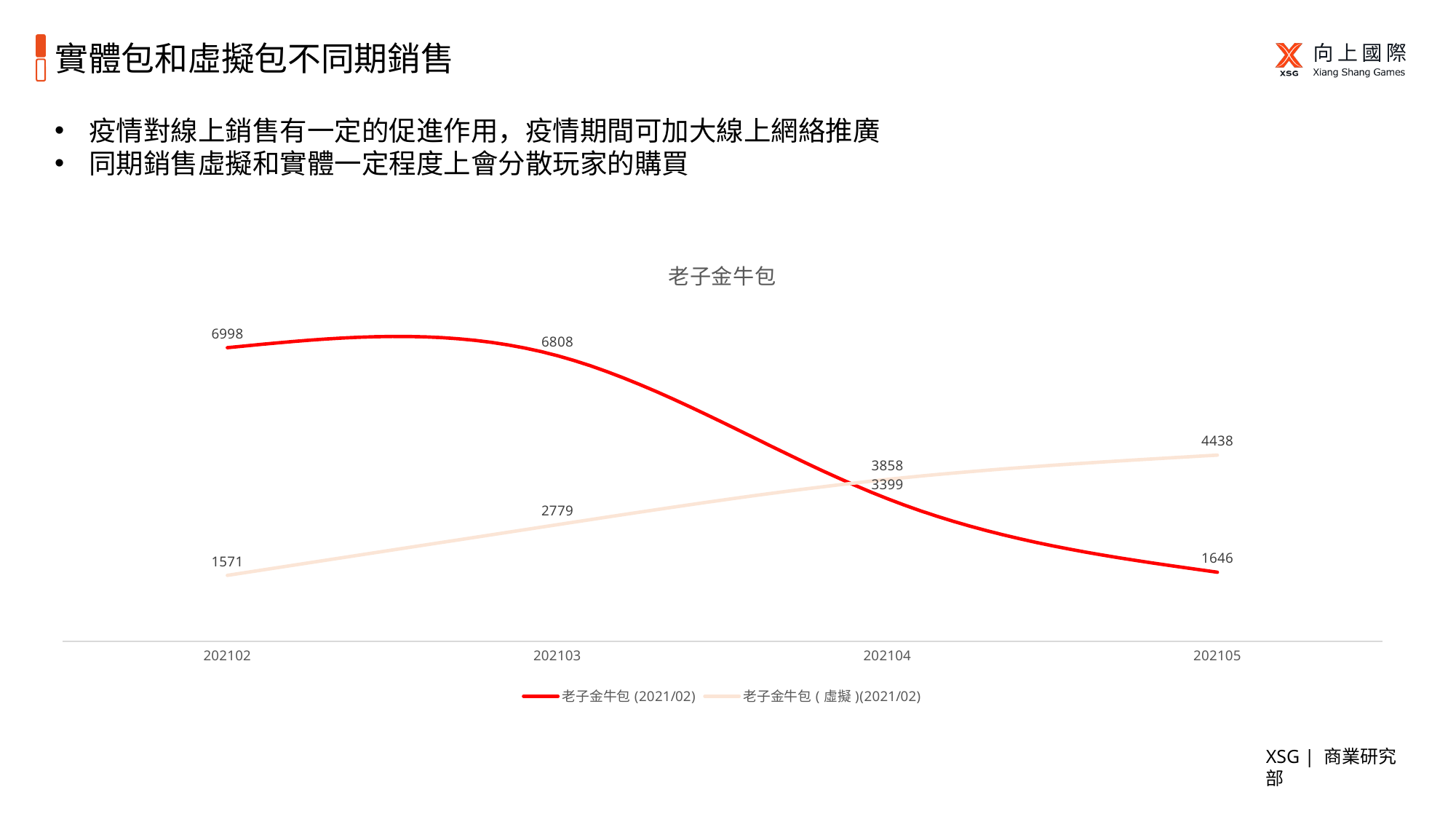
Does the 老子金牛包 ( 虛擬 )(2021/02) series rise or fall from 202102 to 202105? rise What is the value of 老子金牛包 (2021/02) at 202105? 1646 At which x-axis point is 老子金牛包 ( 虛擬 )(2021/02) lowest? 202102 At which x-axis point is 老子金牛包 (2021/02) highest? 202102 How many points are plotted along the x axis for each series? 4 At 202105, which series has the larger value, 老子金牛包 (2021/02) or 老子金牛包 ( 虛擬 )(2021/02)? 老子金牛包 ( 虛擬 )(2021/02) What is the value of 老子金牛包 ( 虛擬 )(2021/02) at 202103? 2779 What is the value of 老子金牛包 (2021/02) at 202102? 6998 How many series does the legend list? 2 What is the value of 老子金牛包 ( 虛擬 )(2021/02) at 202105? 4438 What type of chart is shown on the slide? line chart What is the difference between 老子金牛包 (2021/02) and 老子金牛包 ( 虛擬 )(2021/02) at 202102? 5427